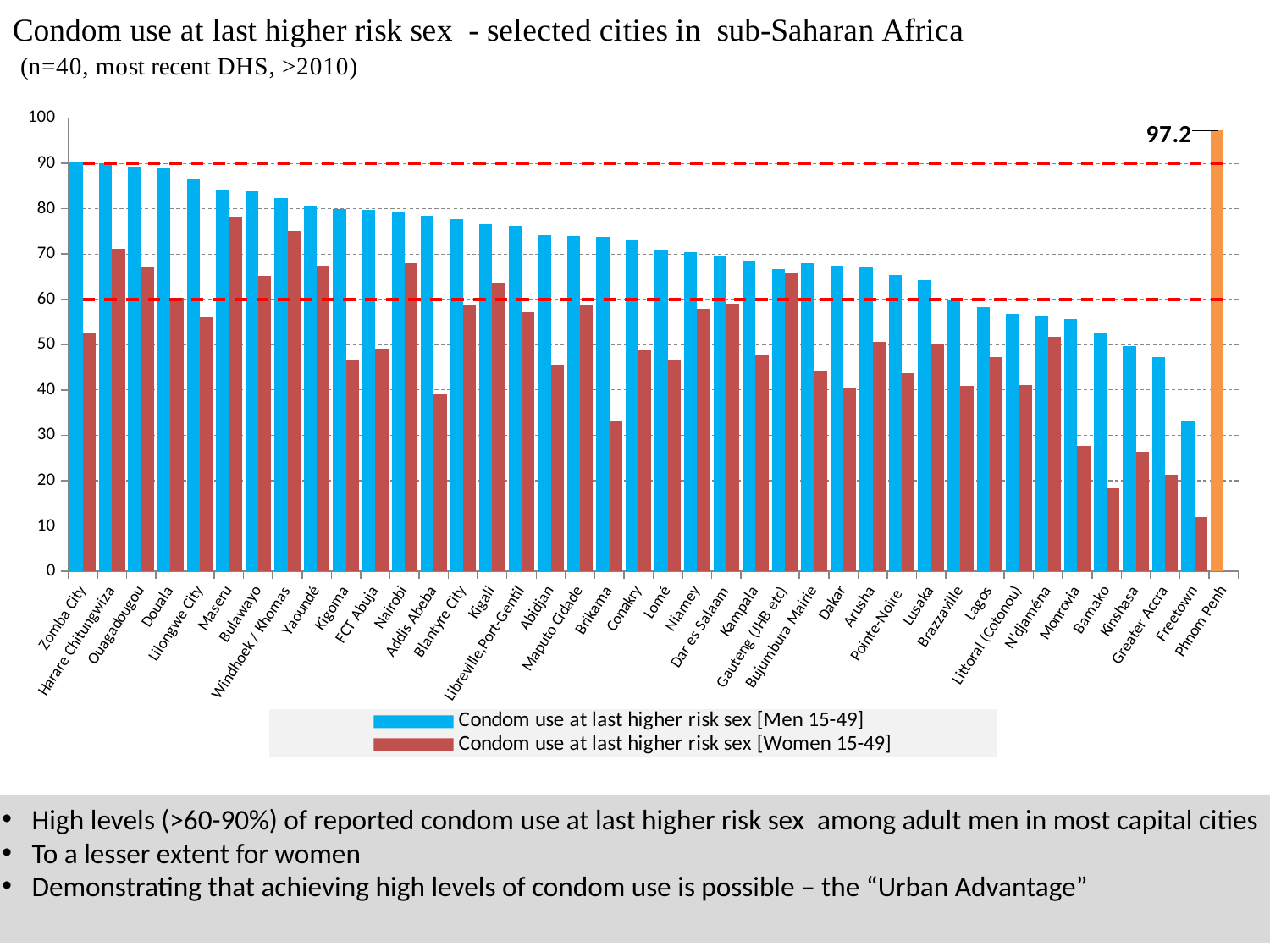
What value is labelled on the Phnom Penh bar? 97.2 Is the men's value for Freetown greater or less than 40? less What kind of chart is shown on the slide? bar chart Which city has the lowest women's (red) bar? Freetown Is the women's value for Maseru greater or less than 70? greater How many series does the legend list? 2 For Kinshasa, which is larger: the men's value or the women's value? men's value Is the women's value for Freetown greater or less than 20? less At which two values on the y axis are the red dashed horizontal lines drawn? 90 and 60 Do the men's (blue) bars generally rise or fall from left to right across the cities? fall Which city has the lowest men's (blue) bar? Freetown